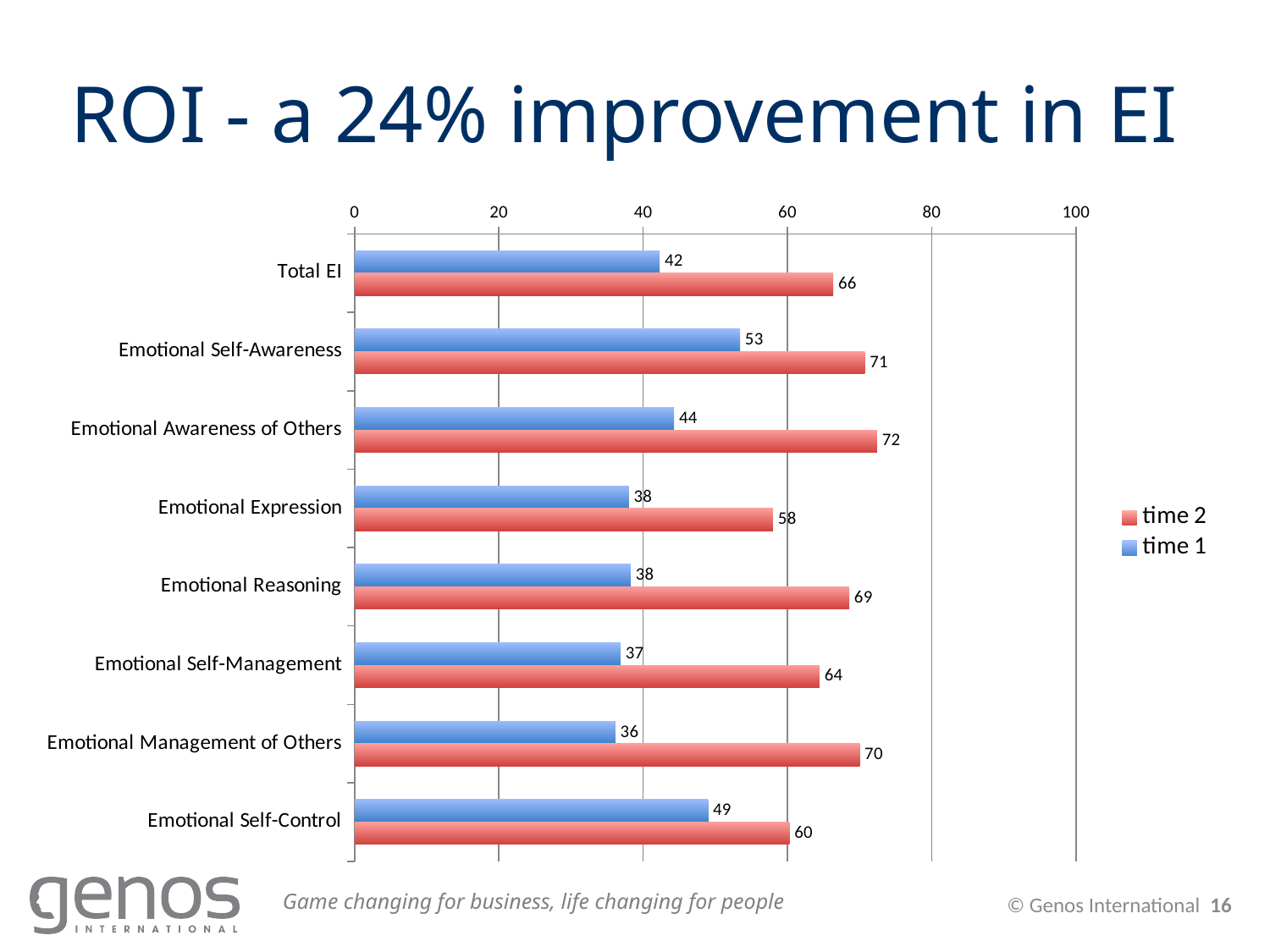
How many categories are shown on the chart? 8 What is the time 1 value for Total EI? 42 Is the time 2 value for Emotional Expression greater or less than 60? less Which category has the lowest time 1 value? Emotional Management of Others Which colour represents the time 1 series? blue What kind of chart is shown on the slide? bar chart What is the time 1 value for Emotional Self-Control? 49 What is the time 2 value for Emotional Awareness of Others? 72 What is the difference between the time 2 and time 1 values for Emotional Reasoning? 31 Which category has the highest time 2 value? Emotional Awareness of Others How many series does the legend list? 2 Which is larger: the time 2 value for Emotional Self-Awareness or the time 2 value for Emotional Self-Management? Emotional Self-Awareness